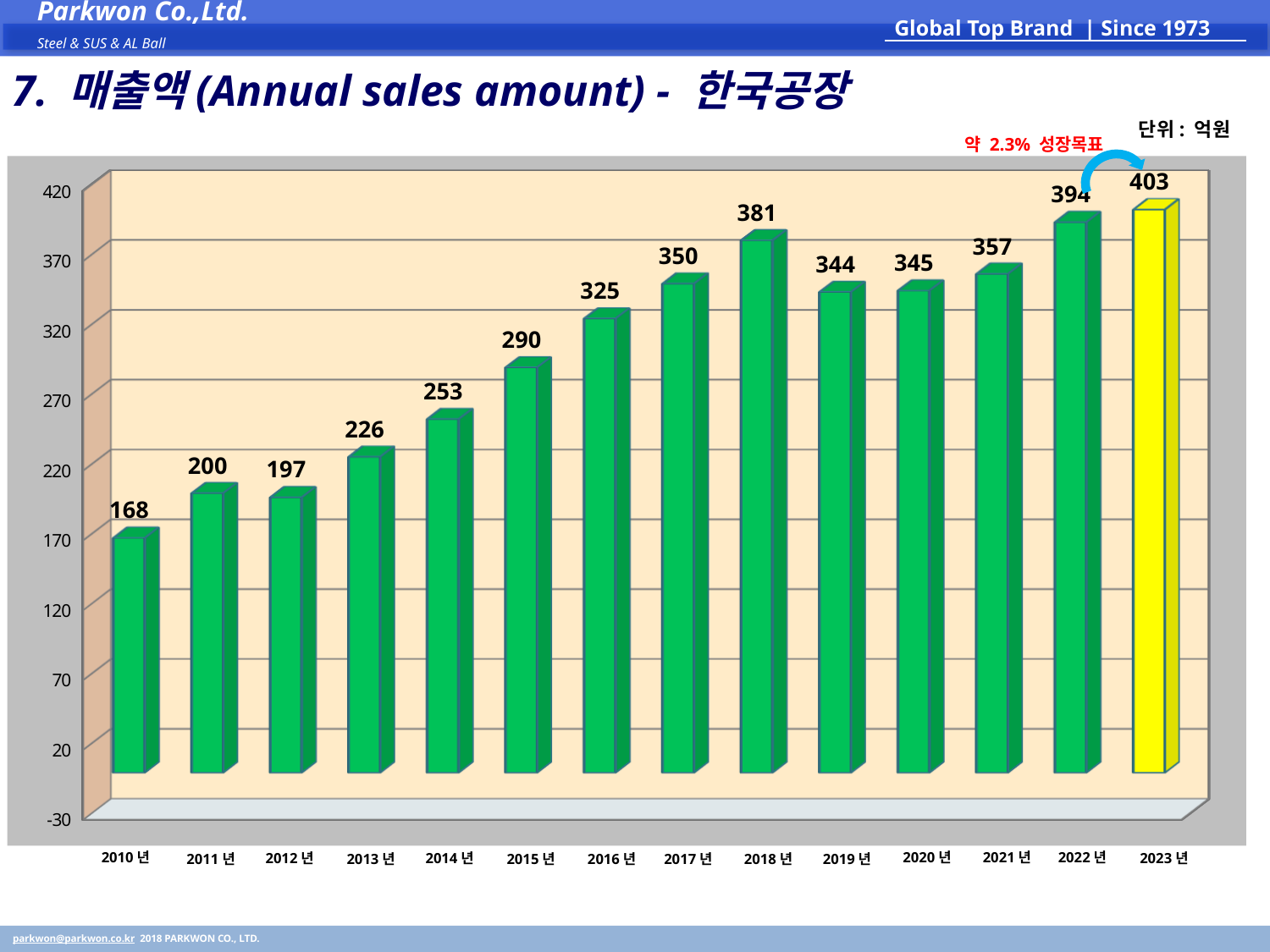
Do the values generally rise or fall from 2010 년 to 2023 년? rise What is the difference between the values for 2022 년 and 2021 년? 37 How many years are shown on the x axis? 14 What colour is the bar for 2023 년? yellow What is the annual sales amount for 2018 년? 381 What is the value shown for 2023 년? 403 Which is larger, the value for 2018 년 or the value for 2019 년? 2018 년 What kind of chart is shown on the slide? bar chart What is the difference between the values for 2011 년 and 2012 년? 3 Which year has the lowest annual sales amount? 2010 년 Which year has the highest annual sales amount? 2023 년 What is the annual sales amount for 2010 년? 168